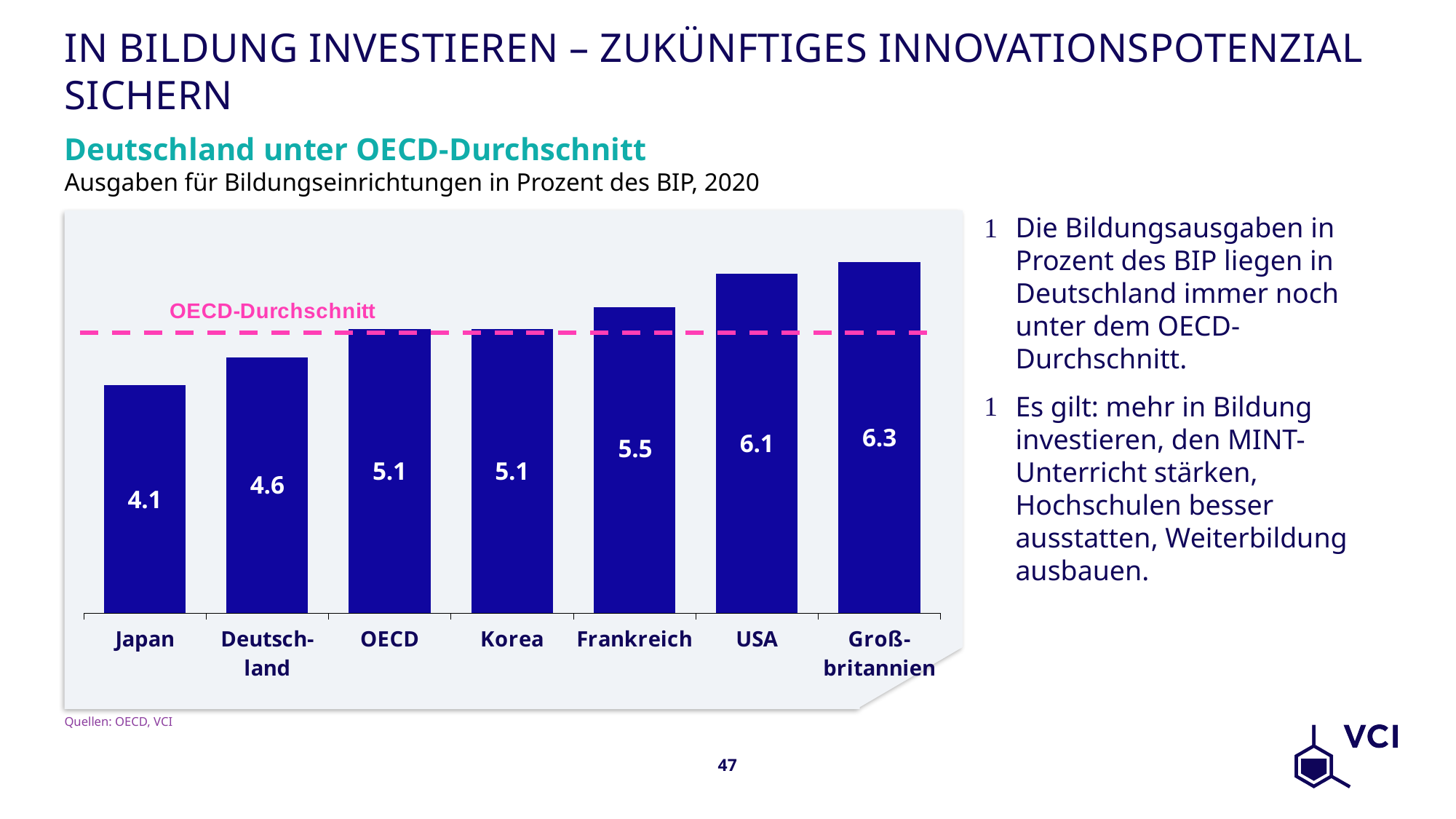
What is the difference between the values for Großbritannien and Japan? 2.2 Which category has the highest value? Großbritannien What is the value for Frankreich? 5.5 What kind of chart is this? Bar chart Which category has the lowest value? Japan What is the difference between the OECD value and the value for Deutschland? 0.5 What is the value for Deutschland? 4.6 Do the values rise or fall from left to right along the x axis? Rise What is the value for USA? 6.1 What does the pink dashed line represent? OECD-Durchschnitt How many categories are shown on the x axis? 7 Which is larger, the value for Frankreich or the value for Korea? Frankreich